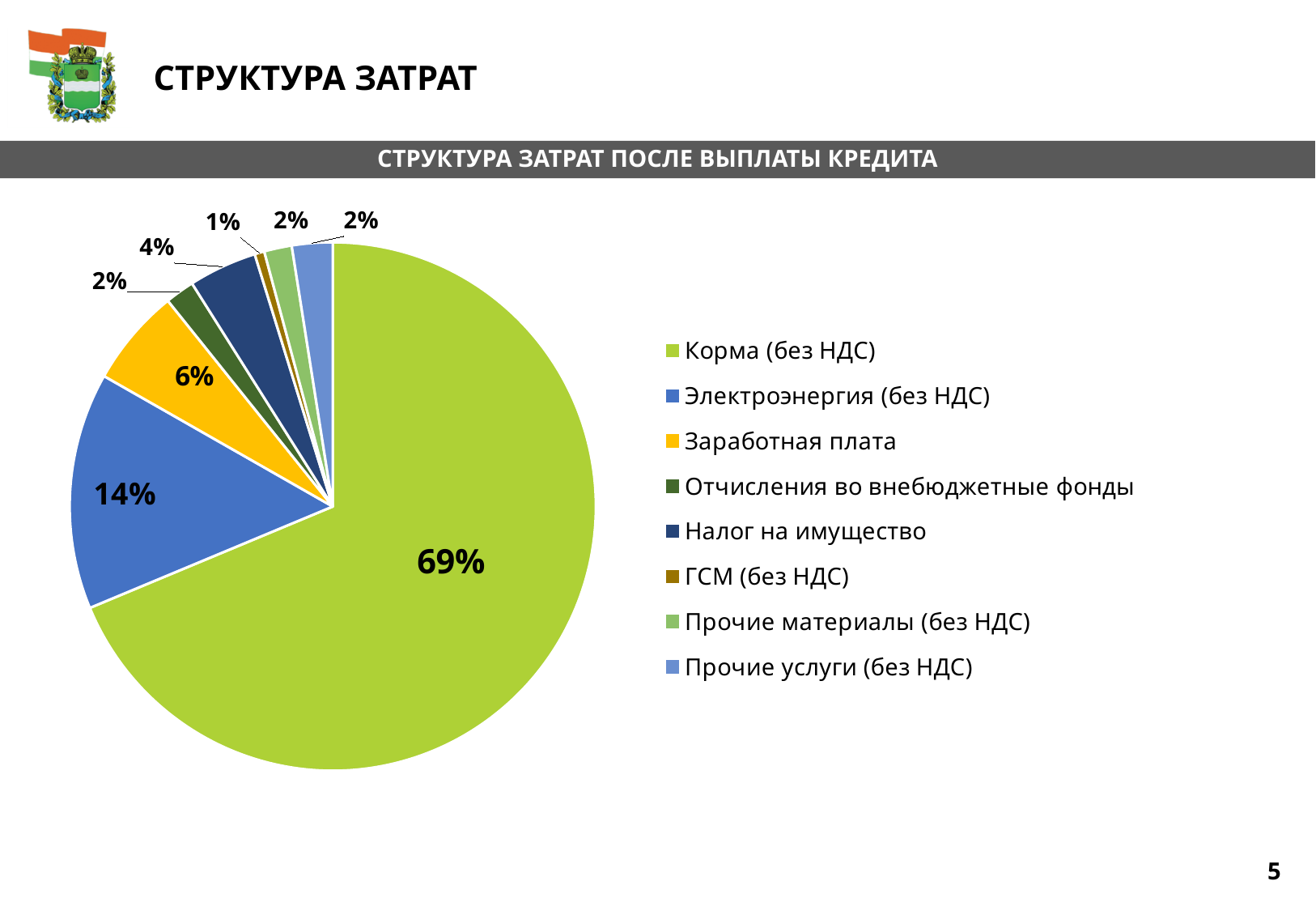
Which category has the smallest share of the pie? ГСМ (без НДС) What share of costs is Корма (без НДС)? 69% What share of costs is Электроэнергия (без НДС)? 14% How many categories does the legend list? 8 Which category has the largest share of the pie? Корма (без НДС) What share of costs is Налог на имущество? 4% What kind of chart is shown on the slide? pie chart What is the difference in percentage points between Корма (без НДС) and Электроэнергия (без НДС)? 55 Which is larger, the share for Заработная плата or the share for Налог на имущество? Заработная плата What is the title of the chart? СТРУКТУРА ЗАТРАТ ПОСЛЕ ВЫПЛАТЫ КРЕДИТА